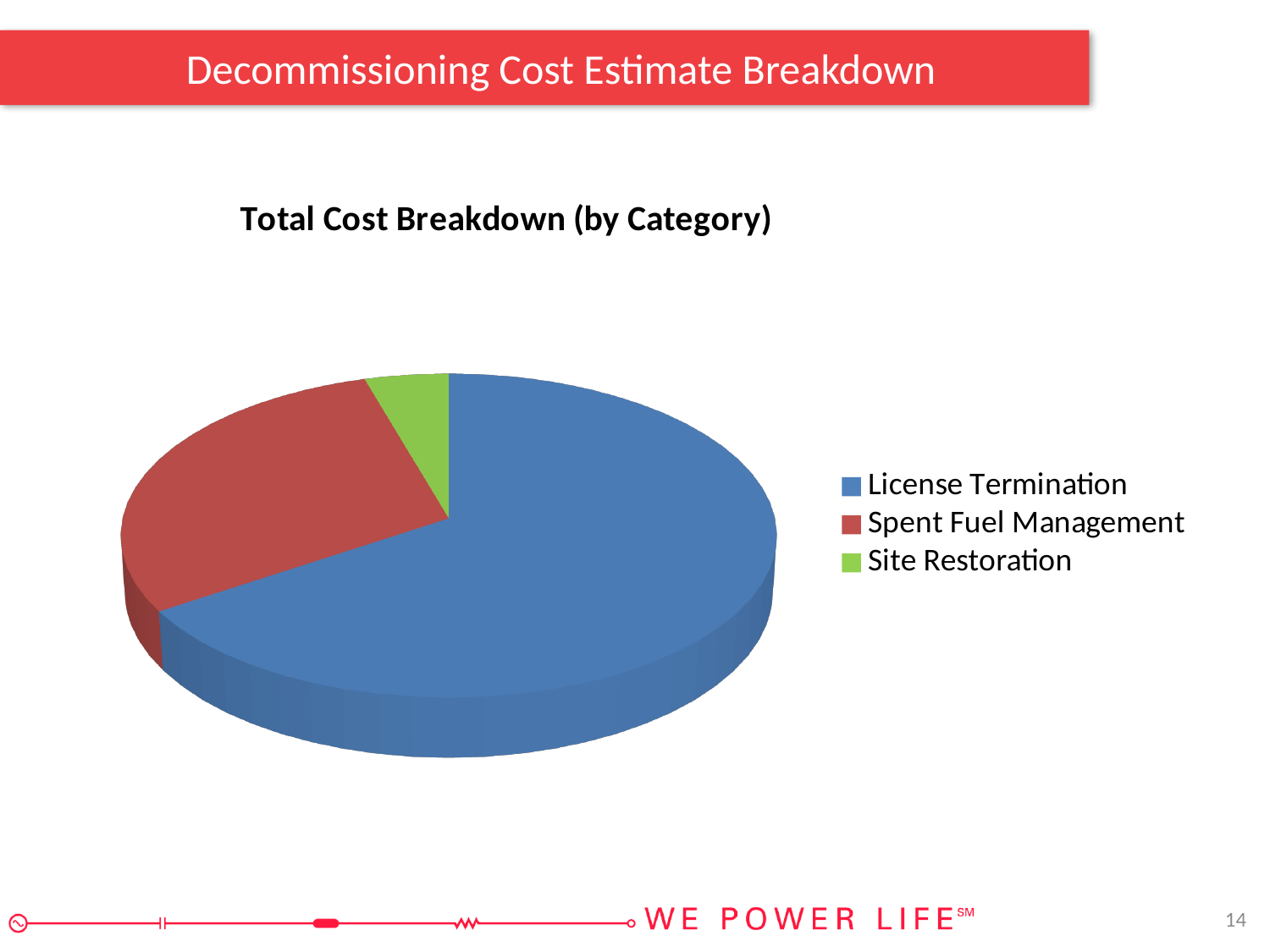
What kind of chart is shown on the slide? pie chart Which category has the smallest slice of the pie? Site Restoration How many categories does the pie chart show? 3 Which slice is larger, License Termination or Spent Fuel Management? License Termination What is the title of the chart? Total Cost Breakdown (by Category) Which slice is larger, Spent Fuel Management or Site Restoration? Spent Fuel Management Which category has the largest slice of the pie? License Termination How many entries does the legend list? 3 Which colour represents Spent Fuel Management in the chart? red